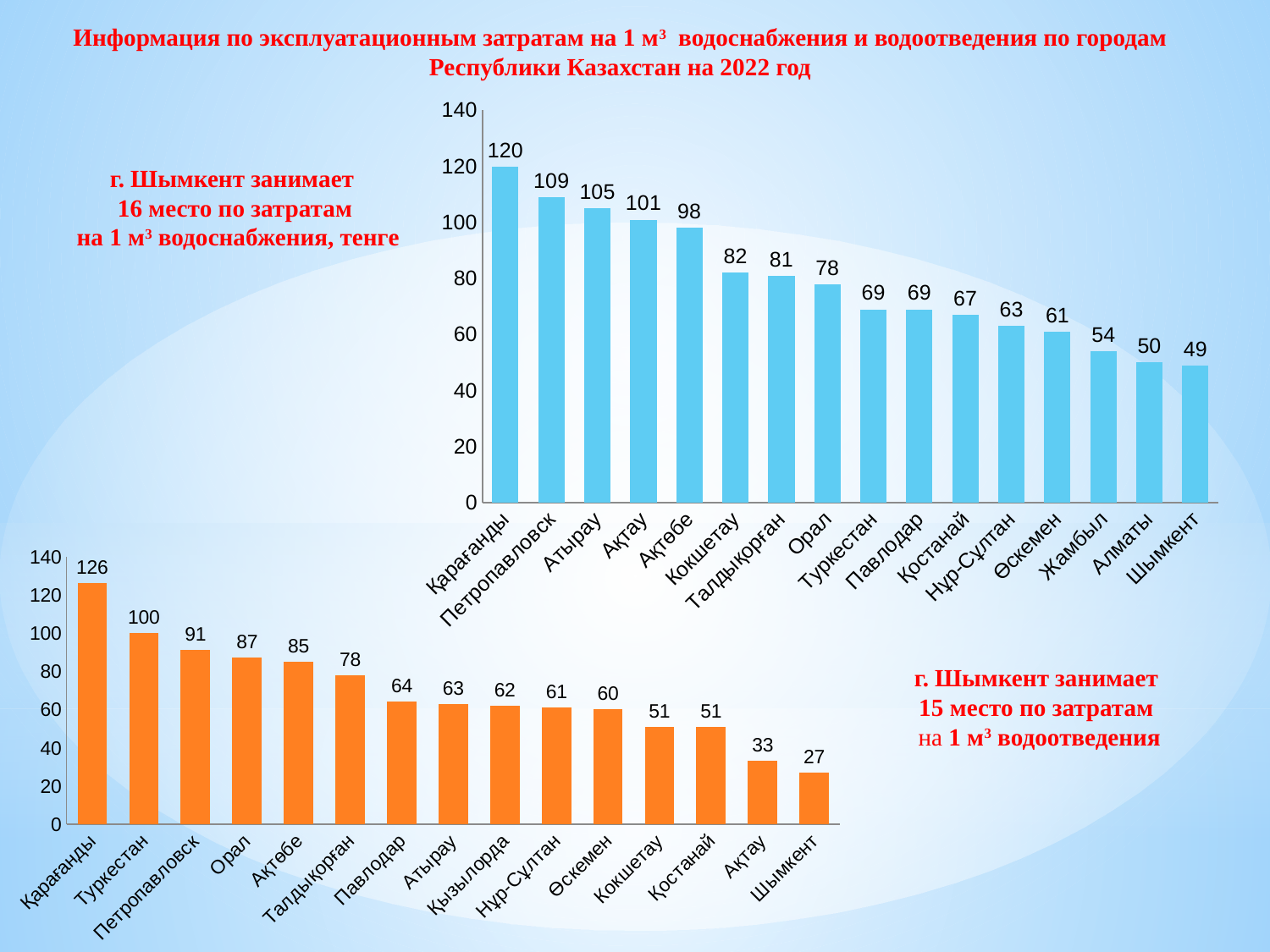
In the top (blue) chart, which is larger: the value for Кокшетау or the value for Орал? Кокшетау In the top (blue) chart, what is the difference between the values for Қарағанды and Шымкент? 71 In the bottom (orange) chart, what is the difference between the values for Туркестан and Ақтау? 67 What kind of chart is the bottom (orange) chart? bar chart In the top (blue) chart, do the values rise or fall from left to right along the x axis? fall In the bottom (orange) chart, what is the value for Орал? 87 How many cities are shown in the bottom (orange) chart? 15 In the bottom (orange) chart, which city has the lowest value? Шымкент In the bottom (orange) chart, is the value for Петропавловск greater or less than 80? greater In the top (blue) chart, which city has the highest value? Қарағанды In the top (blue) chart, what is the value for Атырау? 105 How many cities are shown in the top (blue) chart? 16